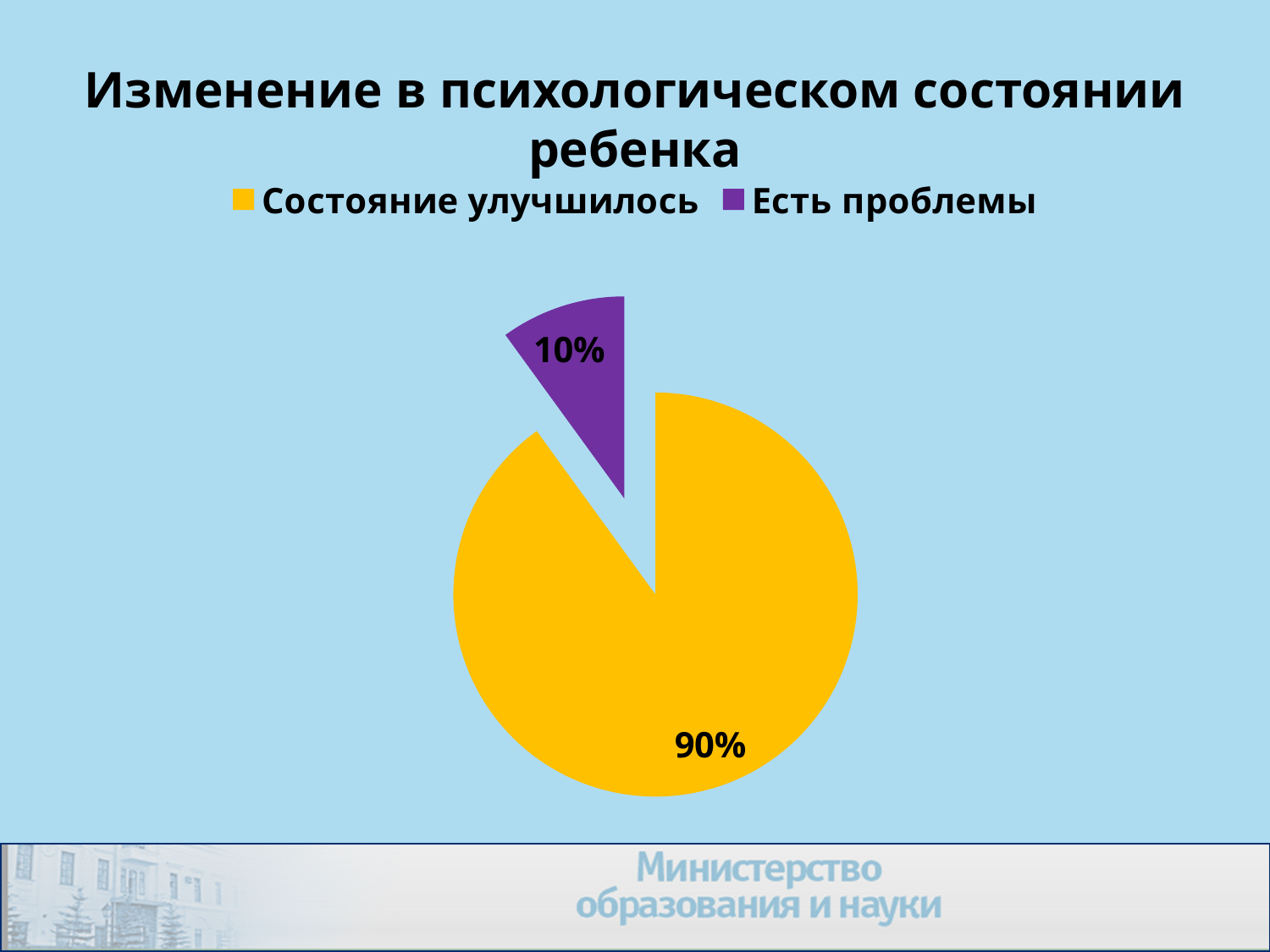
Which category has the largest share of the pie? Состояние улучшилось What is the title of the chart? Изменение в психологическом состоянии ребенка Which category has the smallest share of the pie? Есть проблемы What is the value for "Есть проблемы"? 10% What is the difference between the shares of "Состояние улучшилось" and "Есть проблемы"? 80% How many entries does the legend list? 2 Which is larger: the share for "Состояние улучшилось" or for "Есть проблемы"? Состояние улучшилось How many slices does the pie chart have? 2 What share of the pie does the "Есть проблемы" slice represent? 10% What kind of chart is shown on the slide? pie chart What is the value for "Состояние улучшилось"? 90% What colour is the "Есть проблемы" slice? purple